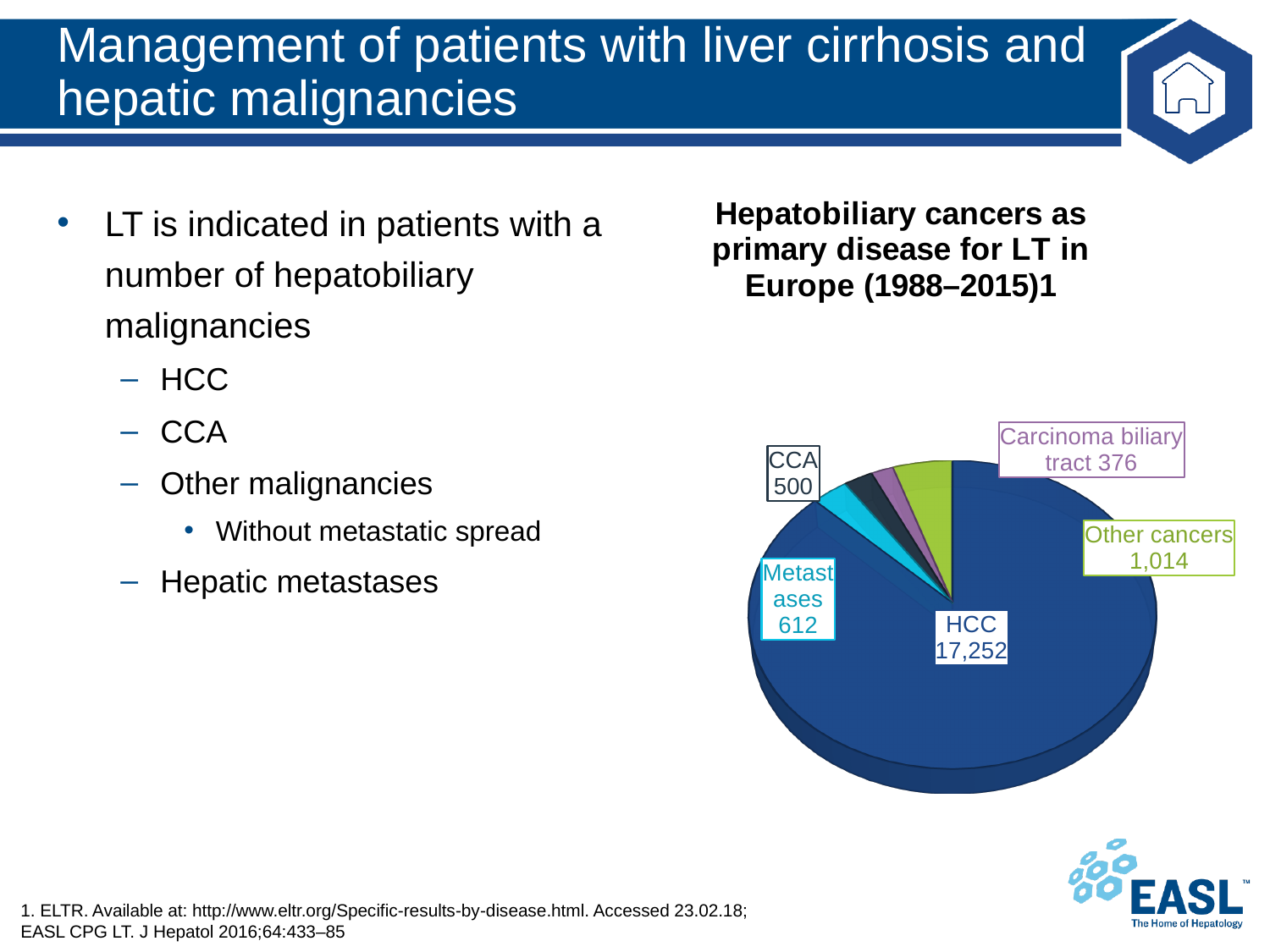
What is the value shown for Metastases in the pie chart? 612 What is the value shown for Other cancers in the pie chart? 1,014 Which is larger in the pie chart, Metastases or CCA? Metastases Which category has the largest slice in the pie chart? HCC What is the difference between the values for Metastases and CCA? 112 What is the title of the pie chart? Hepatobiliary cancers as primary disease for LT in Europe (1988–2015) What is the value shown for HCC in the pie chart? 17,252 What is the difference between the values for Other cancers and Carcinoma biliary tract? 638 What is the value shown for Carcinoma biliary tract in the pie chart? 376 Which category has the smallest slice in the pie chart? Carcinoma biliary tract What kind of chart is shown on the slide? Pie chart How many slices does the pie chart have? 5